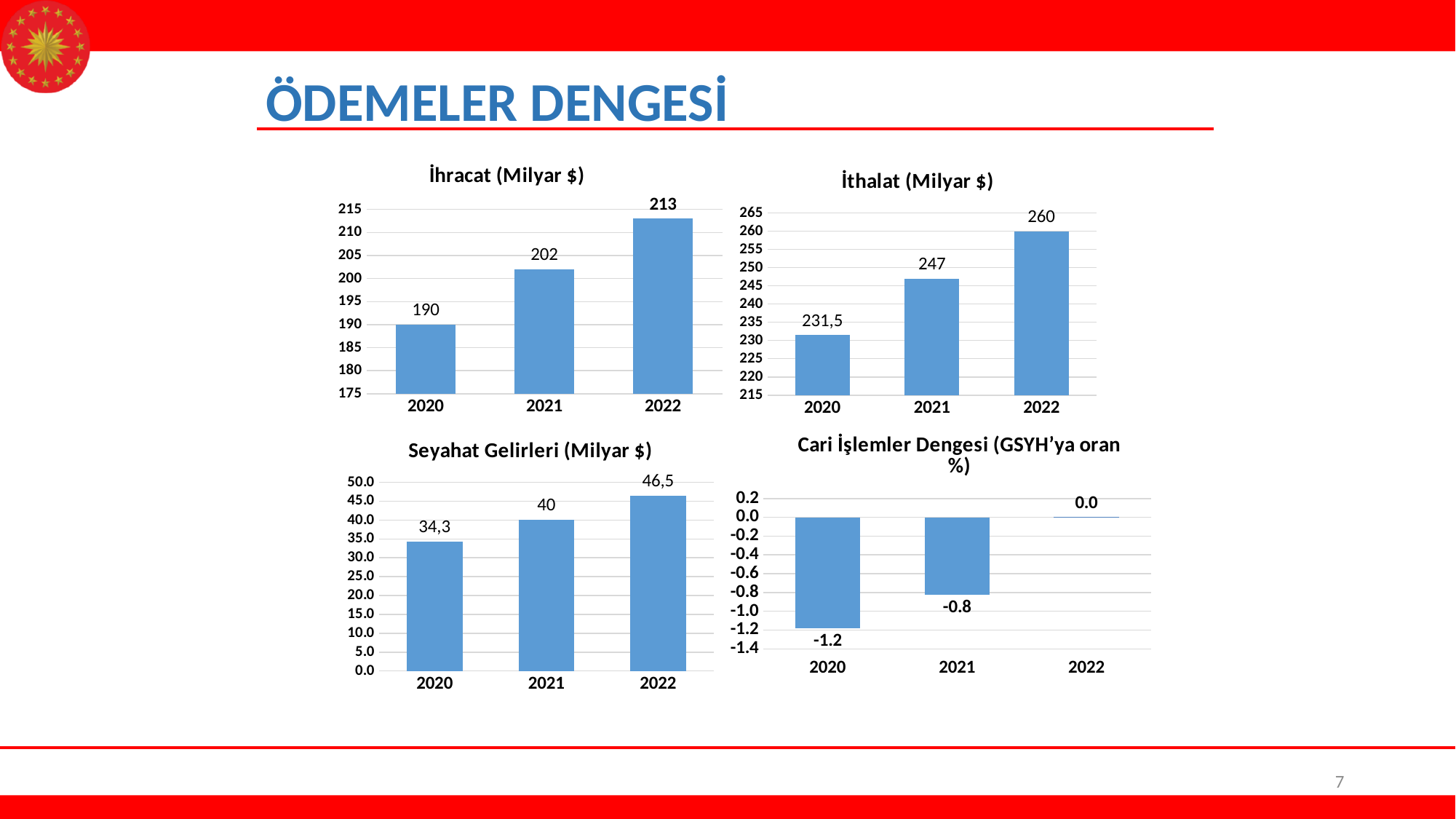
How many charts are shown on the slide? 4 In the 'Seyahat Gelirleri (Milyar $)' chart, what is the value for 2022? 46,5 In the 'Seyahat Gelirleri (Milyar $)' chart, is the value for 2021 larger or smaller than the value for 2020? larger In the 'Cari İşlemler Dengesi (GSYH'ya oran %)' chart, what is the value for 2022? 0.0 In the 'İthalat (Milyar $)' chart, what is the value for 2020? 231,5 In the 'İhracat (Milyar $)' chart, which year has the lowest value? 2020 In the 'İhracat (Milyar $)' chart, what is the difference between the 2022 and 2020 values? 23 In the 'Cari İşlemler Dengesi (GSYH'ya oran %)' chart, what is the value for 2020? -1.2 In the 'İthalat (Milyar $)' chart, what is the difference between the 2022 and 2021 values? 13 In the 'İthalat (Milyar $)' chart, which year has the highest value? 2022 In the 'Seyahat Gelirleri (Milyar $)' chart, do the values rise or fall from 2020 to 2022? rise In the 'İhracat (Milyar $)' chart, what is the value for 2022? 213